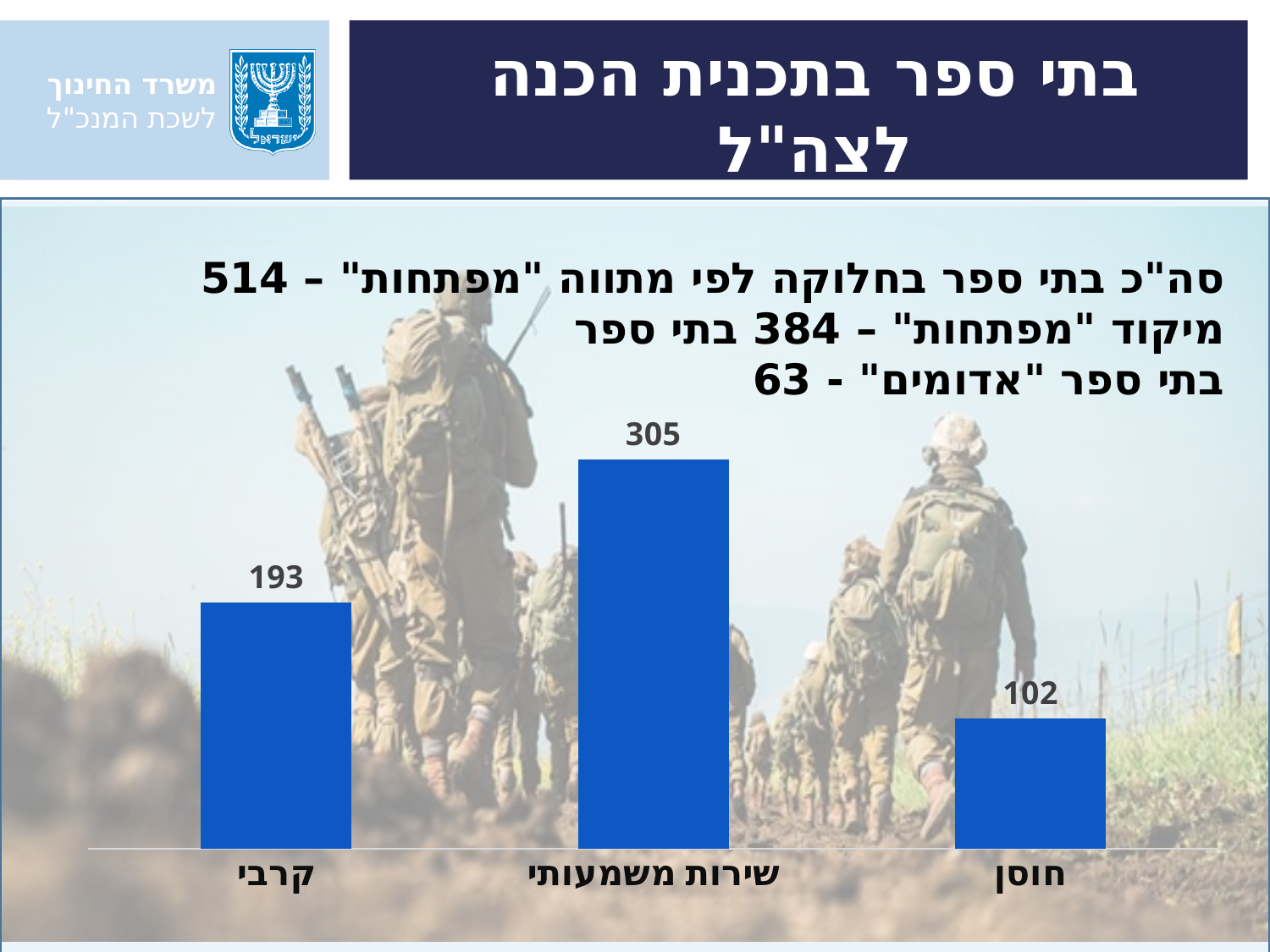
What is the value for שירות משמעותי? 305 What is the value for חוסן? 102 What is the difference between the values for קרבי and חוסן? 91 What kind of chart is shown on the slide? bar chart What is the value for קרבי? 193 Which category has the lowest value? חוסן How many categories are shown in the chart? 3 What is the difference between the values for שירות משמעותי and קרבי? 112 What is the total of the three bar values in the chart? 600 Which is larger, the value for קרבי or the value for חוסן? קרבי What colour are the bars in the chart? blue Which category has the highest value? שירות משמעותי